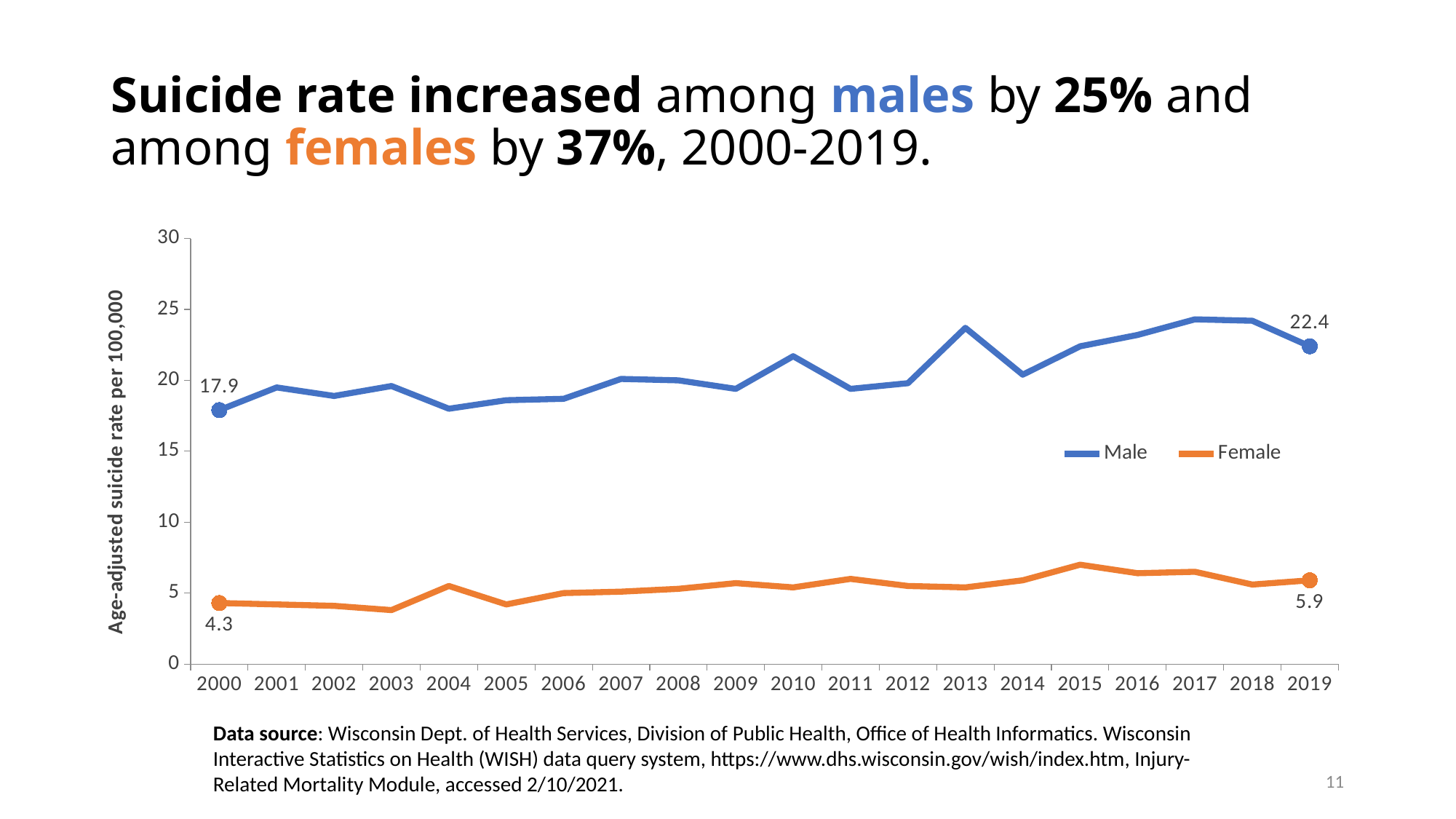
How many years are shown on the x axis? 20 By how much did the male suicide rate change from 2000 to 2019? 4.5 What is the difference between the male and female suicide rates in 2019? 16.5 What kind of chart is shown on the slide? line chart Is the male suicide rate in 2013 greater or less than 20? greater What is the male suicide rate in 2019? 22.4 What is the female suicide rate in 2000? 4.3 Which is larger, the male suicide rate in 2000 or in 2019? 2019 Is the female suicide rate in 2003 greater or less than 5? less What is the male suicide rate in 2000? 17.9 What is the female suicide rate in 2019? 5.9 How many series does the legend list? 2